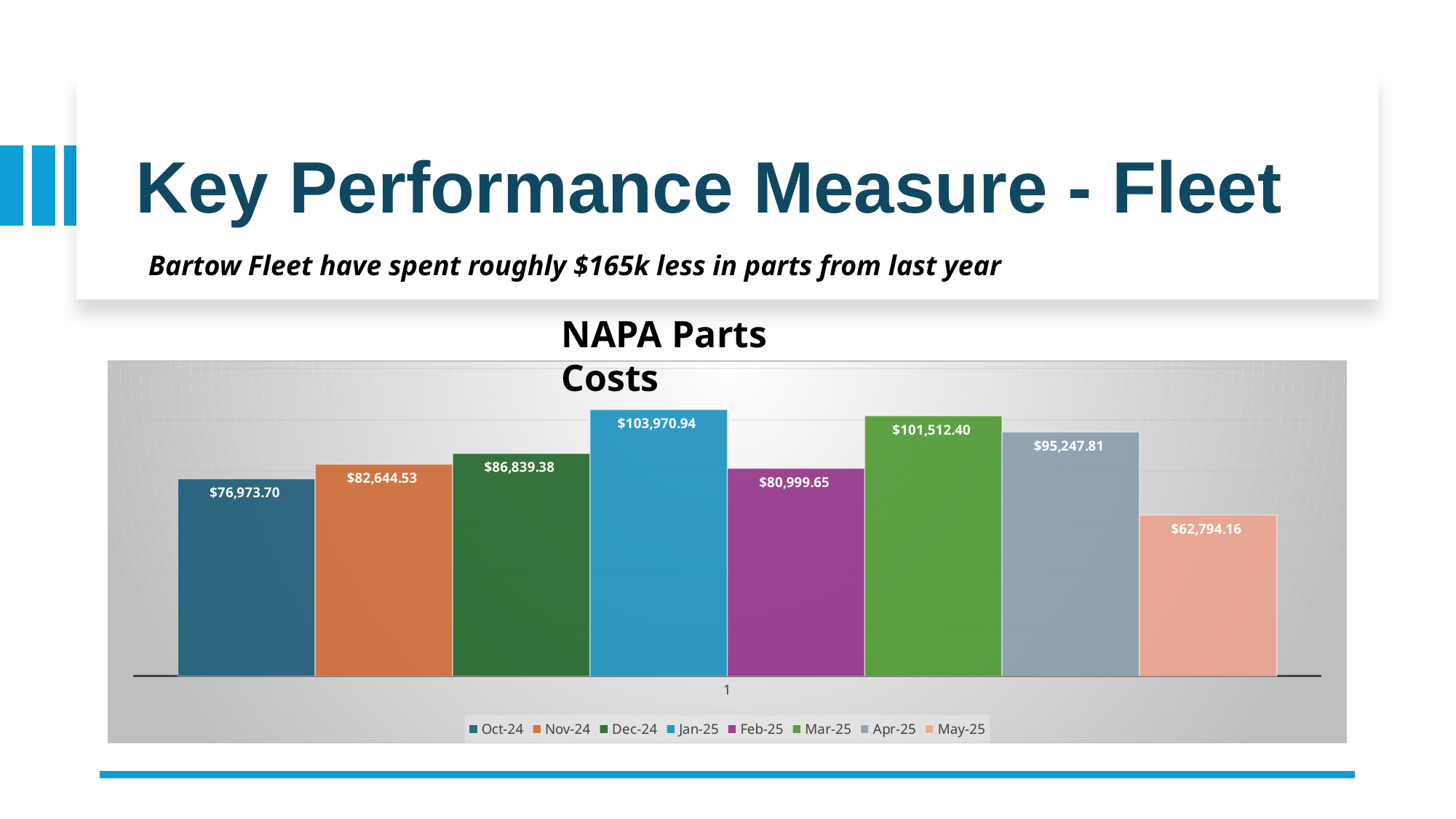
Which month has the lowest NAPA Parts Cost? May-25 What is the difference between the NAPA Parts Costs for Jan-25 and May-25? $41,176.78 Which is larger, the NAPA Parts Cost for Apr-25 or for Dec-24? Apr-25 How many months are shown in the NAPA Parts Costs chart? 8 What is the NAPA Parts Cost for May-25? $62,794.16 What is the difference between the NAPA Parts Costs for Mar-25 and Feb-25? $20,512.75 What kind of chart is the NAPA Parts Costs chart? Bar chart What is the NAPA Parts Cost for Apr-25? $95,247.81 How many series does the legend of the NAPA Parts Costs chart list? 8 Which month has the highest NAPA Parts Cost? Jan-25 What is the NAPA Parts Cost for Dec-24? $86,839.38 What is the NAPA Parts Cost for Jan-25? $103,970.94